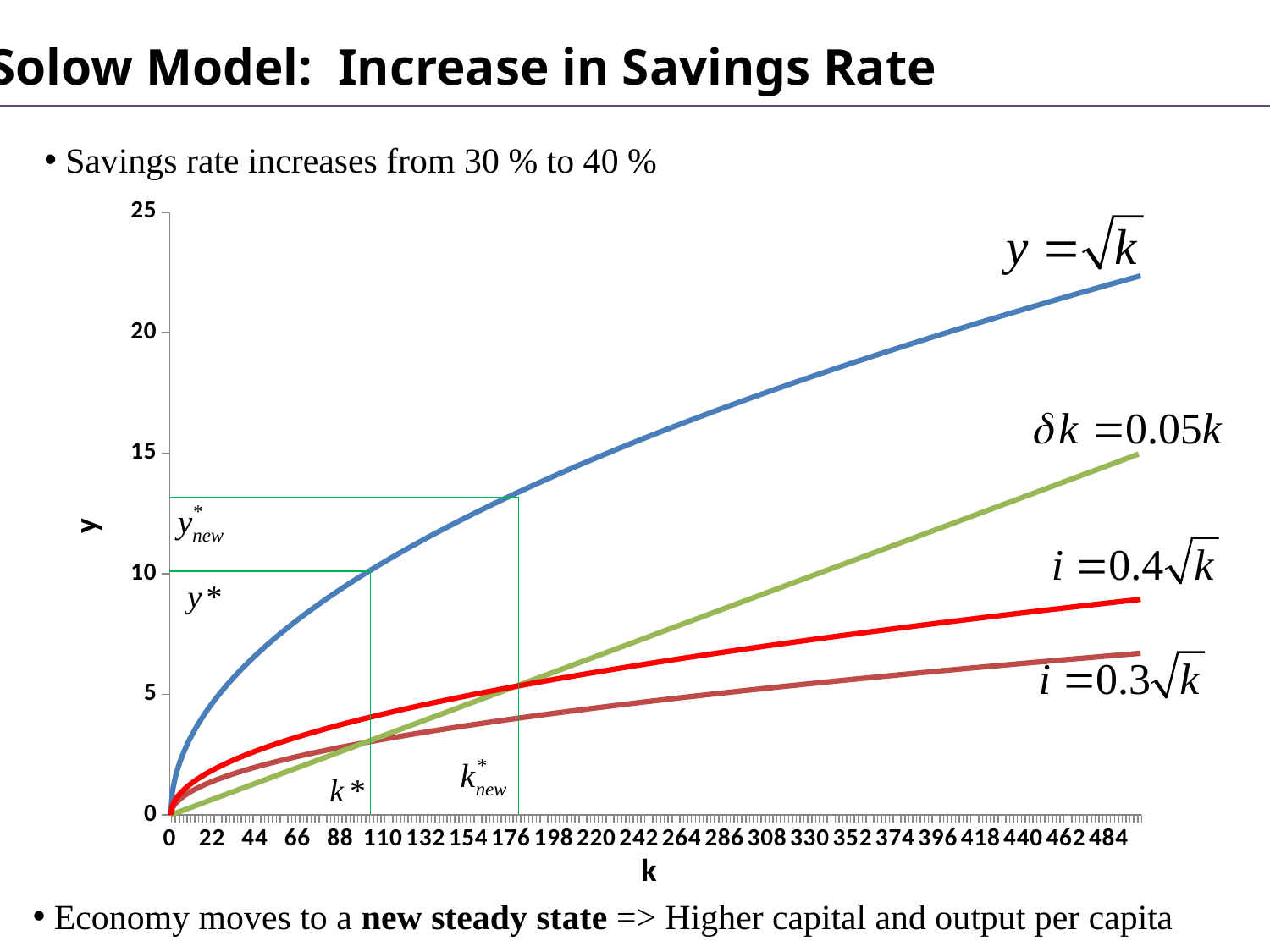
What type of chart is shown on the slide? line chart How many curves are plotted on the chart? 4 What value on the y axis does the y* line correspond to? 10 Does the y = √k curve rise or fall as k increases? rise What is the label of the vertical axis? y Is the value of i = 0.4√k at k = 484 greater or less than 10? less Is the value of δk = 0.05k at k = 484 greater or less than 10? greater Which curve is the highest across the chart? y = √k Which curve is the lowest at the right end of the chart (k = 484)? i = 0.3√k At k = 484, which curve is higher: i = 0.4√k or i = 0.3√k? i = 0.4√k What is the label of the horizontal axis? k Is the value of y = √k at k = 484 greater or less than 20? greater